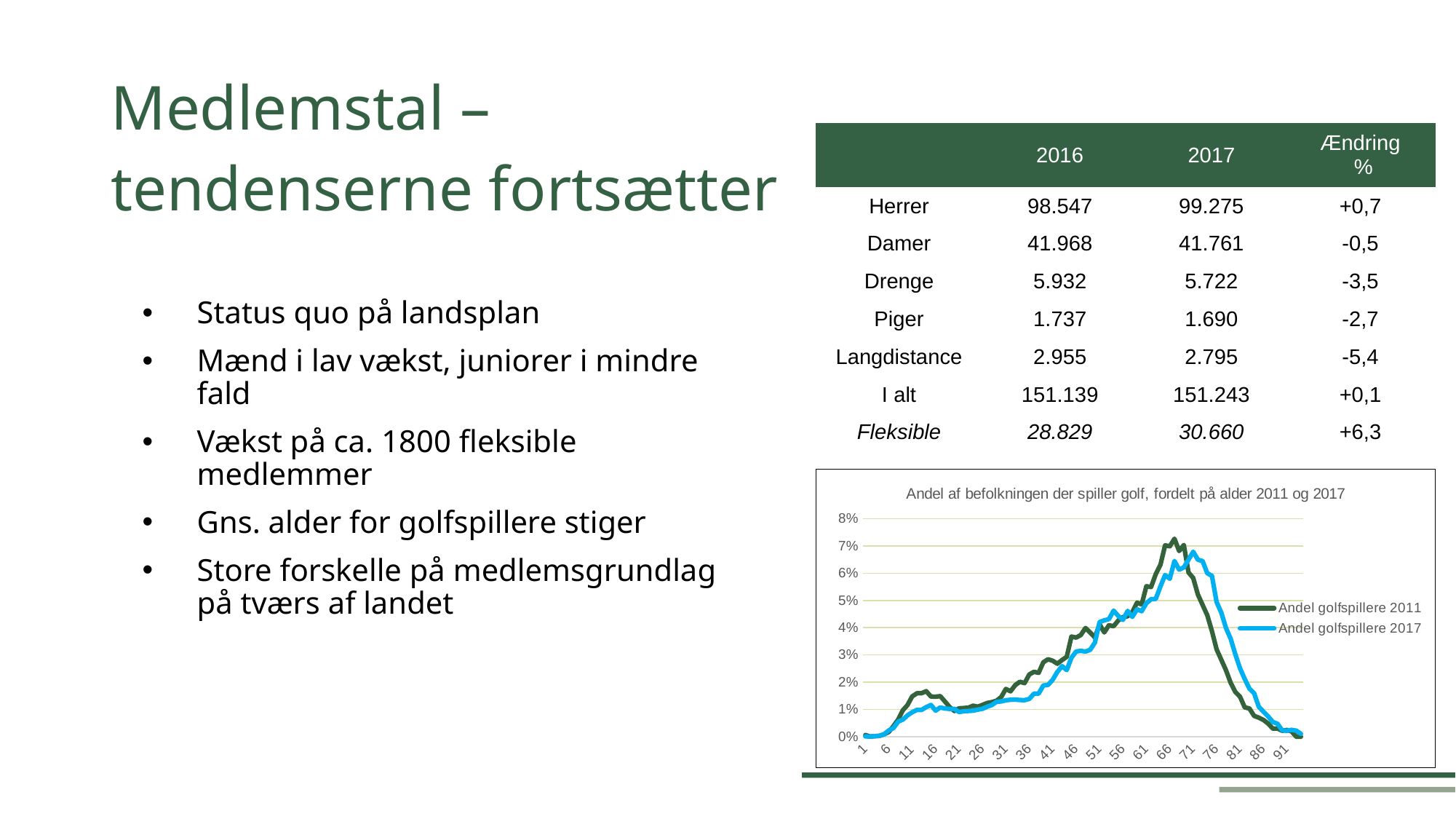
Is the value for 'Andel golfspillere 2011' at age 66 greater or less than 6%? greater Which colour is used for the series 'Andel golfspillere 2017' in the chart? light blue Is the value for 'Andel golfspillere 2011' at age 86 greater or less than 1%? less What is the title of the chart? Andel af befolkningen der spiller golf, fordelt på alder 2011 og 2017 What kind of chart is shown on the slide? line chart At age 71, which series has the higher value, 'Andel golfspillere 2011' or 'Andel golfspillere 2017'? Andel golfspillere 2017 Is the value for 'Andel golfspillere 2011' at age 46 greater or less than 3%? greater Does the 'Andel golfspillere 2017' line rise or fall between age 71 and age 91? fall How many series does the legend of the chart list? 2 At age 11, which series has the higher value, 'Andel golfspillere 2011' or 'Andel golfspillere 2017'? Andel golfspillere 2011 Which series reaches the higher peak value in the chart? Andel golfspillere 2011